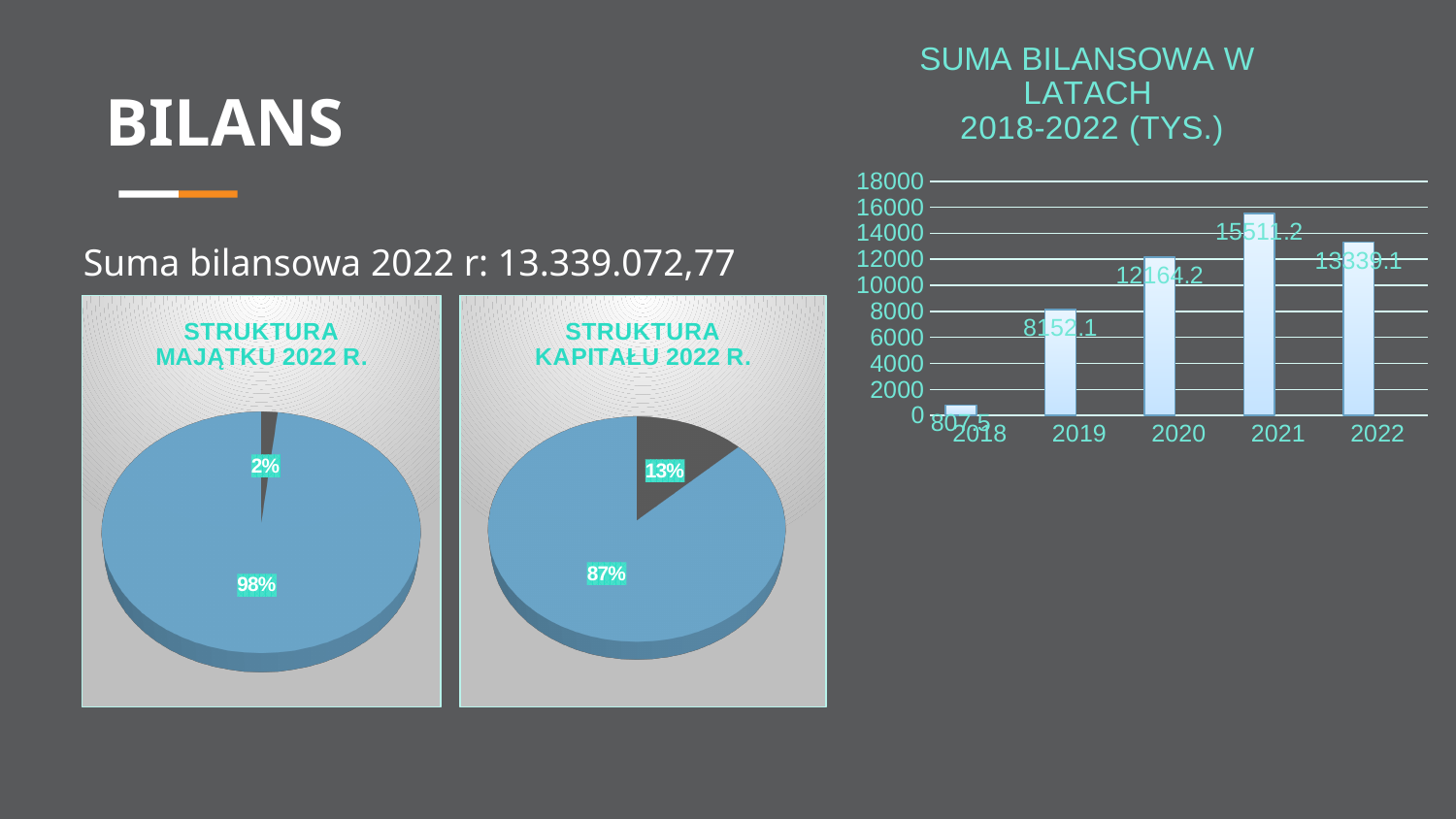
In the chart titled 'SUMA BILANSOWA W LATACH 2018-2022 (TYS.)', how many years are shown on the x axis? 5 In the chart titled 'SUMA BILANSOWA W LATACH 2018-2022 (TYS.)', which year has the highest value? 2021 In the chart titled 'SUMA BILANSOWA W LATACH 2018-2022 (TYS.)', what is the difference between the values for 2021 and 2022? 2172.1 In the chart titled 'SUMA BILANSOWA W LATACH 2018-2022 (TYS.)', which year has the lowest value? 2018 In the pie chart titled 'STRUKTURA KAPITAŁU 2022 R.', what share does the smaller slice have? 13% In the chart titled 'SUMA BILANSOWA W LATACH 2018-2022 (TYS.)', what is the value for 2019? 8152.1 In the chart titled 'SUMA BILANSOWA W LATACH 2018-2022 (TYS.)', what is the value for 2021? 15511.2 In the chart titled 'SUMA BILANSOWA W LATACH 2018-2022 (TYS.)', which is larger, the value for 2020 or the value for 2022? 2022 What kind of chart is 'SUMA BILANSOWA W LATACH 2018-2022 (TYS.)'? bar chart In the pie chart titled 'STRUKTURA MAJĄTKU 2022 R.', what share does the larger slice have? 98% In the chart titled 'SUMA BILANSOWA W LATACH 2018-2022 (TYS.)', do the values rise or fall from 2018 to 2021? rise What kind of chart is 'STRUKTURA KAPITAŁU 2022 R.'? pie chart